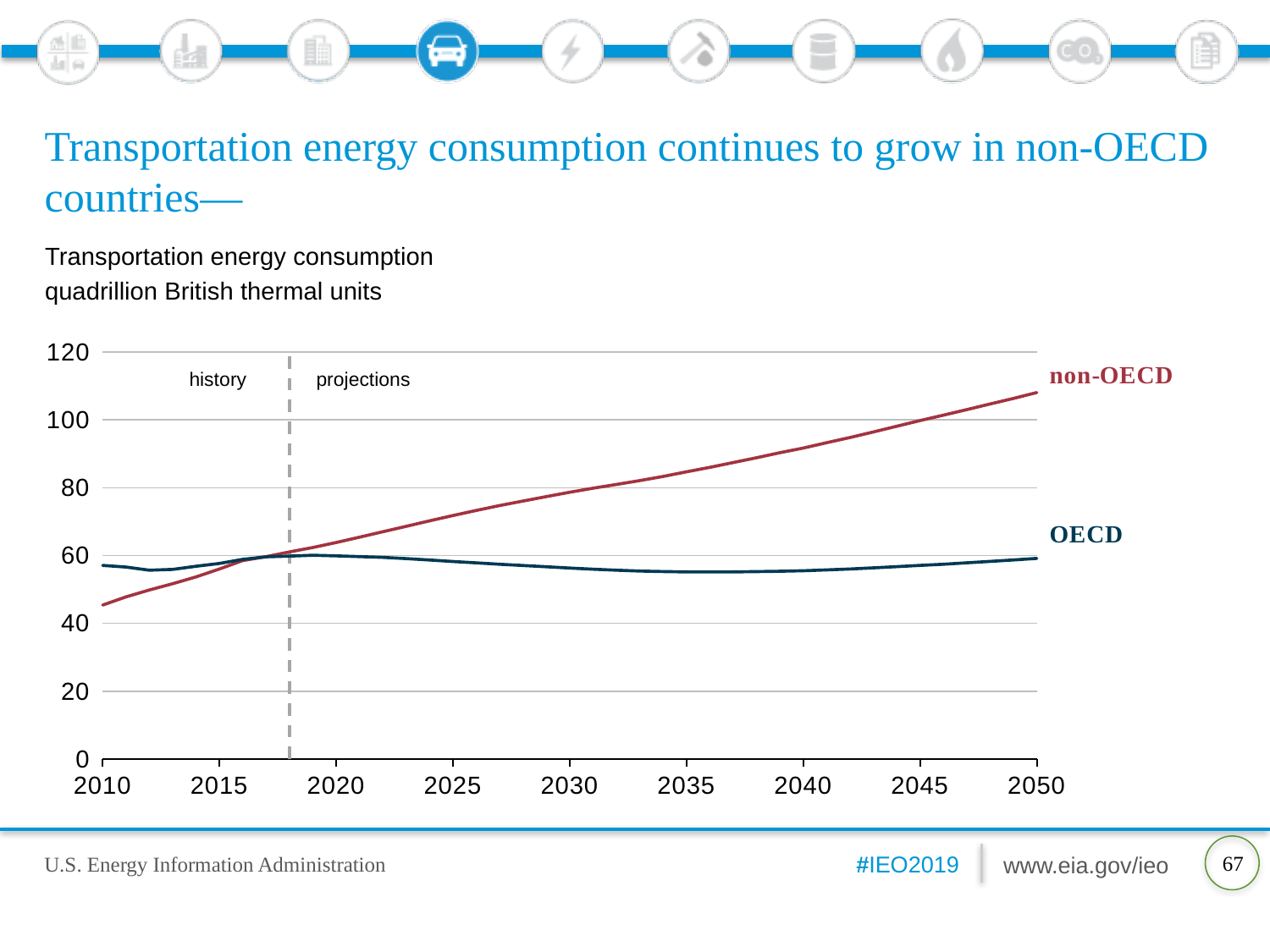
Which series has the higher transportation energy consumption in 2050, non-OECD or OECD? non-OECD Does the non-OECD line rise or fall from 2010 to 2050? rise What kind of chart is shown on the slide? line chart Is the non-OECD value in 2010 greater or less than 60? less Is the non-OECD value in 2040 greater or less than 80? greater Which series has the higher transportation energy consumption in 2010, non-OECD or OECD? OECD Is the non-OECD value in 2050 greater or less than 100? greater What two periods does the dashed vertical line separate on the chart? history and projections How many series are plotted on the chart? 2 What unit is the transportation energy consumption measured in on the chart? quadrillion British thermal units How many year labels are shown on the x axis? 9